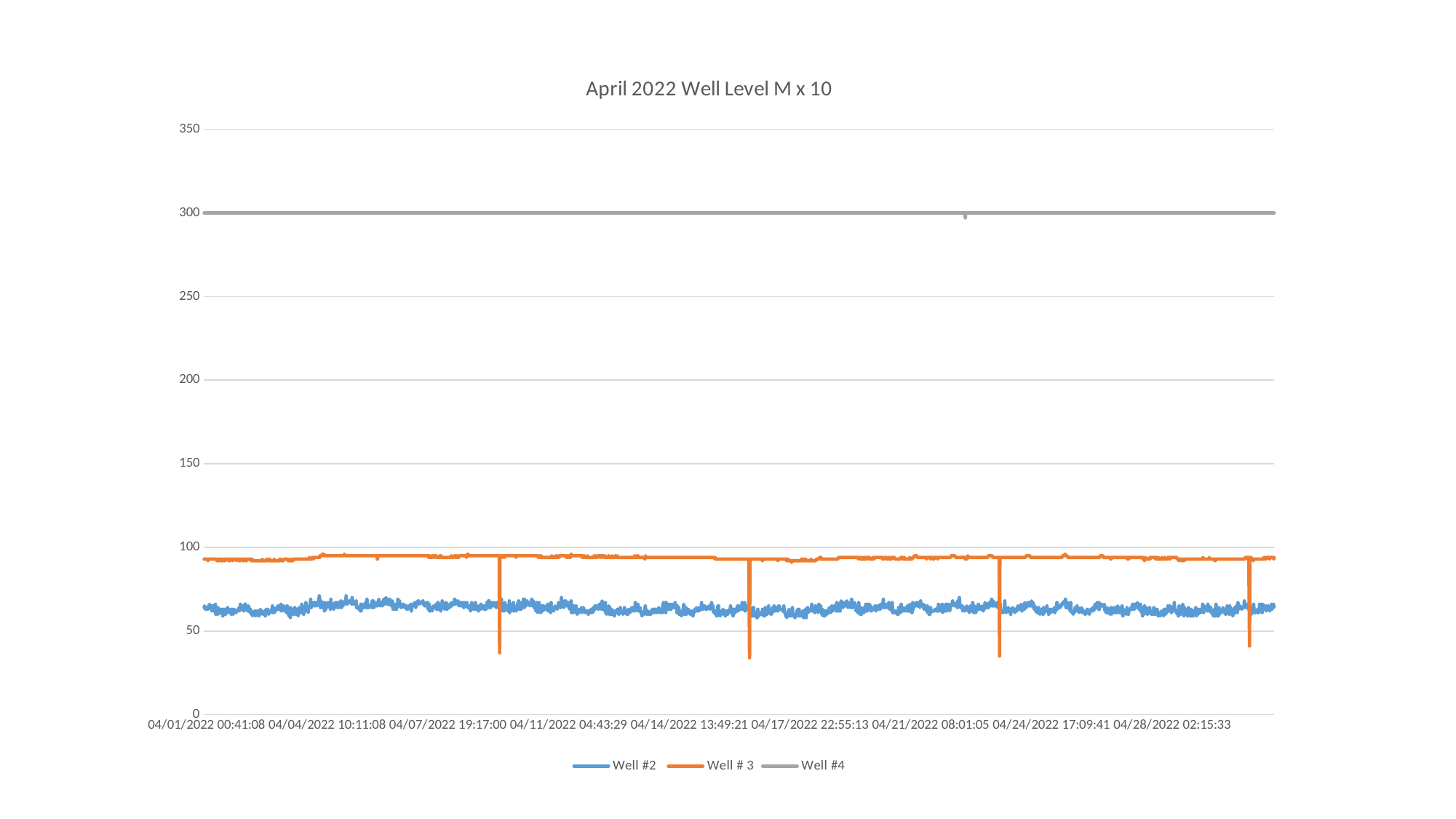
What is the title of the chart? April 2022 Well Level M x 10 Does the Well #4 line rise, fall, or stay flat across the x axis? stay flat Which series is higher, Well # 3 or Well #2? Well # 3 Which series has the highest values throughout the chart? Well #4 What kind of chart is shown on the slide? line chart How many series does the legend list? 3 Is the value for Well #2 greater or less than 100? less Is the typical value for Well # 3 greater or less than 150? less Which series has the lowest values throughout the chart? Well #2 What colour is the Well # 3 line? orange Is the value for Well #4 greater or less than 250? greater Which series is higher, Well #4 or Well # 3? Well #4